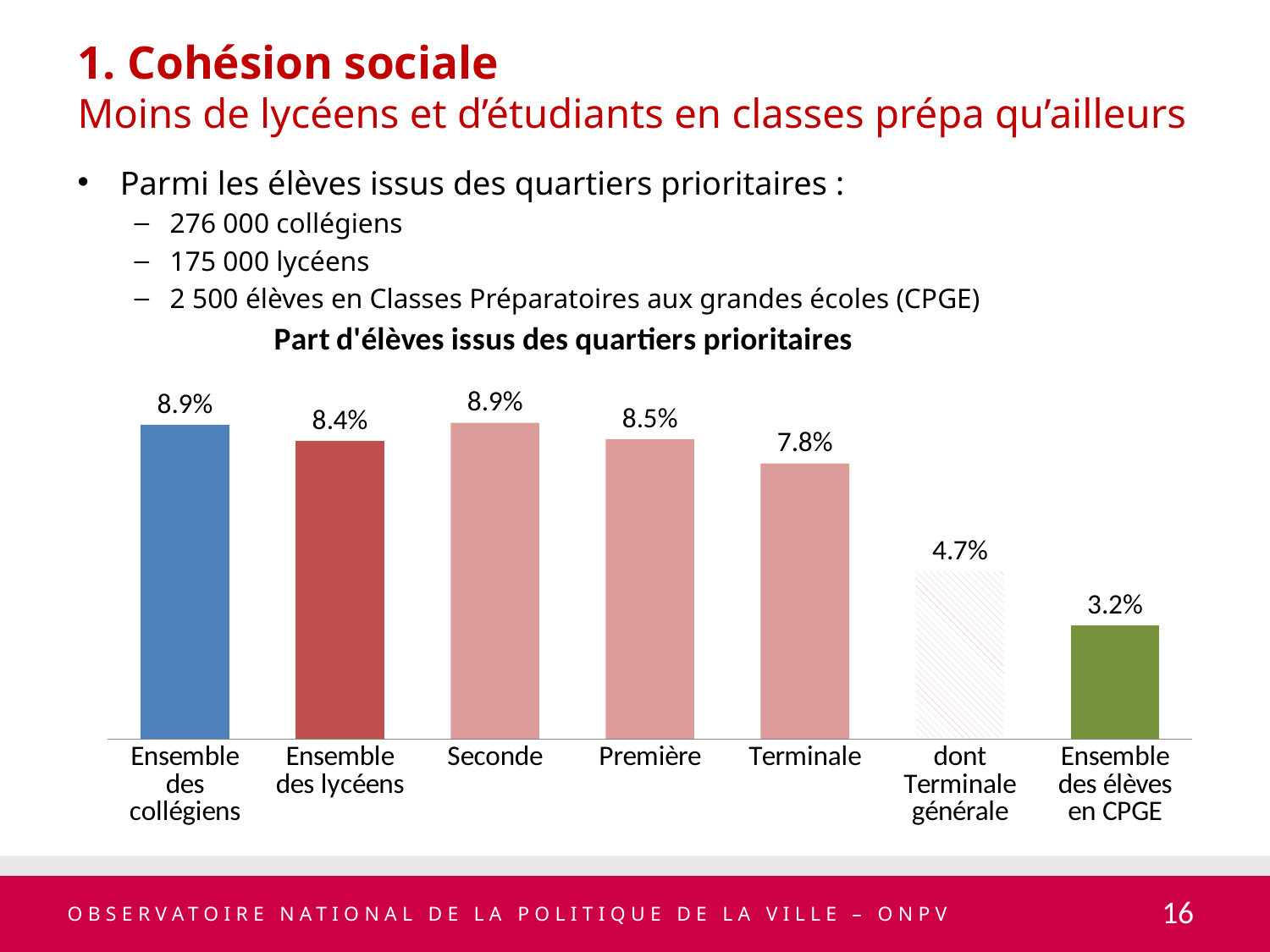
What is the value for dont Terminale générale? 4.7% What kind of chart is this? Bar chart What is the title of the chart? Part d'élèves issus des quartiers prioritaires What is the value for Ensemble des lycéens? 8.4% What is the difference between the values for Ensemble des collégiens and Ensemble des élèves en CPGE? 5.7 percentage points Which is larger, the value for Première or the value for Terminale? Première What is the difference between the values for Terminale and dont Terminale générale? 3.1 percentage points Which category has the lowest value? Ensemble des élèves en CPGE What is the value for Ensemble des collégiens? 8.9% What is the value for Ensemble des élèves en CPGE? 3.2% How many categories are shown in the chart? 7 What is the value for Terminale? 7.8%